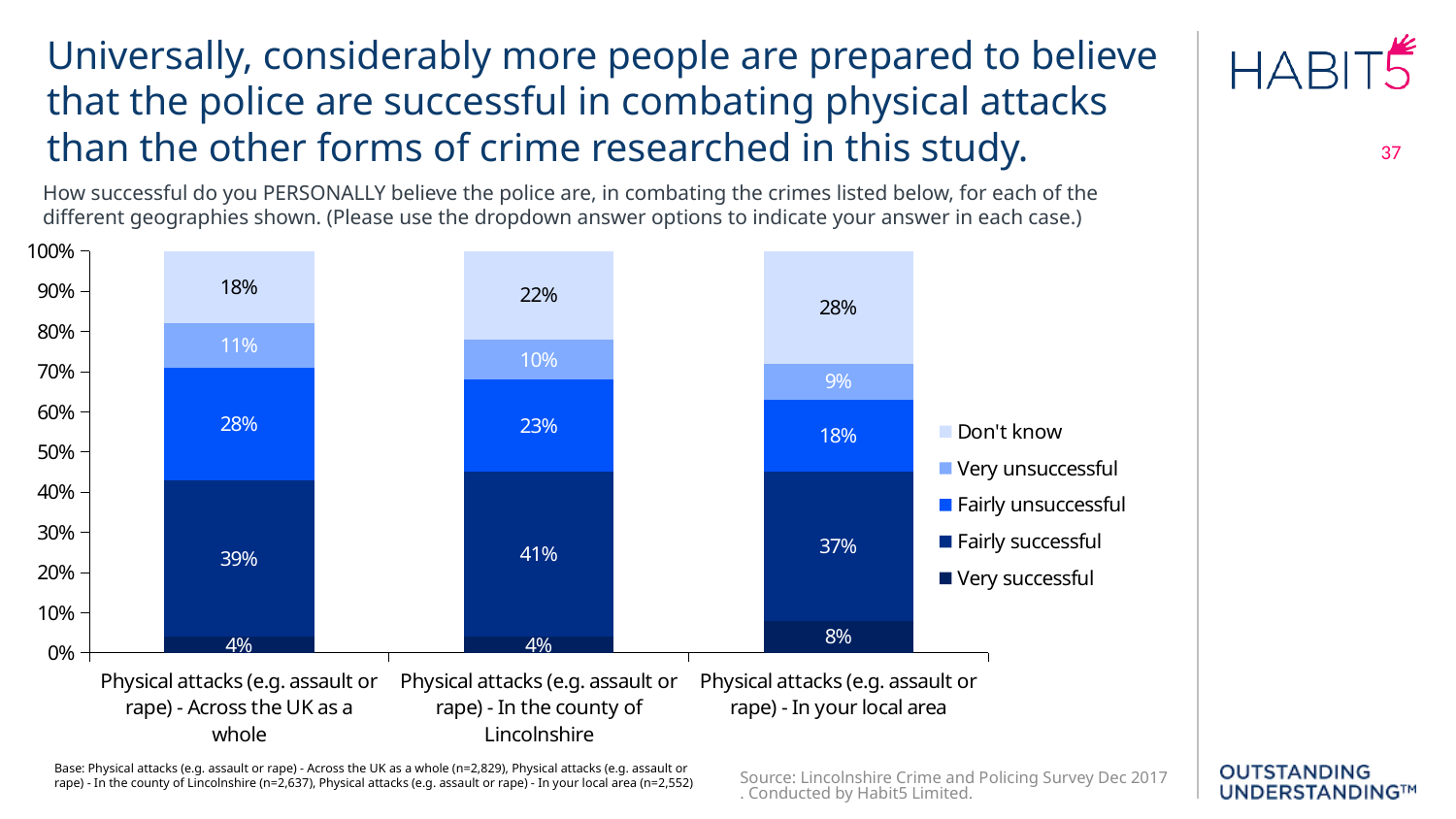
What is the difference between the 'Fairly unsuccessful' values for across the UK as a whole and in your local area? 10% What kind of chart is shown on the slide? Stacked bar chart Which legend entry is shown in the lightest shade of blue? Don't know How many categories are shown on the x axis? 3 What is the 'Don't know' value for physical attacks in your local area? 28% What percentage of respondents said 'Fairly successful' for physical attacks across the UK as a whole? 39% Which geography has the lowest 'Fairly unsuccessful' percentage? Physical attacks (e.g. assault or rape) - In your local area Which geography has the highest 'Very successful' percentage? Physical attacks (e.g. assault or rape) - In your local area What is the combined 'Very successful' and 'Fairly successful' percentage for physical attacks in the county of Lincolnshire? 45% Which is larger: the 'Don't know' value for the county of Lincolnshire or for across the UK as a whole? The county of Lincolnshire How many series does the legend list? 5 What percentage said 'Very successful' for physical attacks in the county of Lincolnshire? 4%